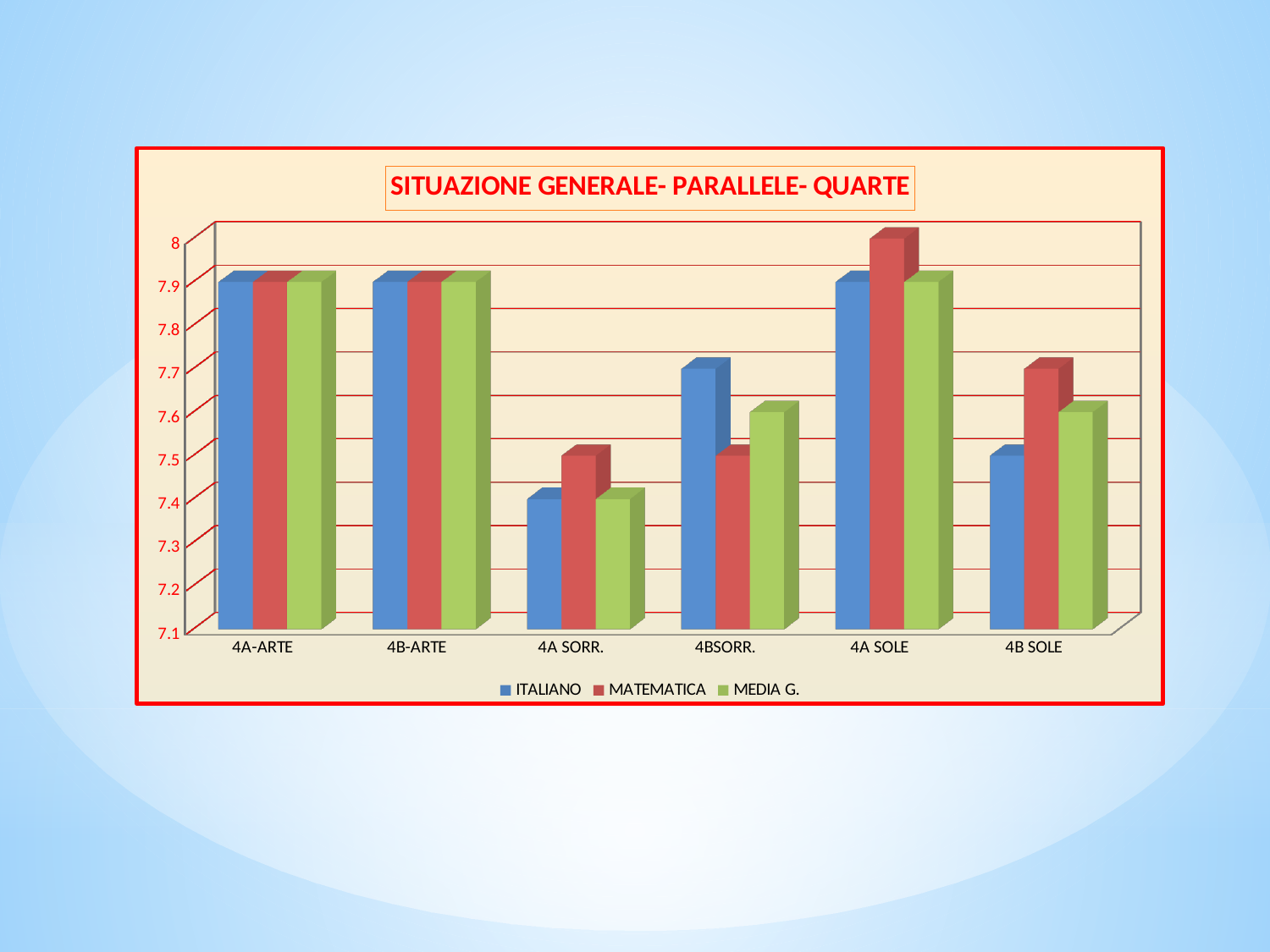
Which category has the lowest ITALIANO value? 4A SORR. Which series is shown in green in the legend? MEDIA G. What is the title of the chart? SITUAZIONE GENERALE- PARALLELE- QUARTE Which is larger for 4BSORR., the ITALIANO value or the MATEMATICA value? ITALIANO Is the MATEMATICA value for 4A SOLE greater or less than 7.9? greater What kind of chart is shown on the slide? bar chart Is the ITALIANO value for 4A SORR. greater or less than 7.5? less Is the ITALIANO value for 4BSORR. greater or less than 7.6? greater How many categories are shown on the x axis? 6 Which is larger for 4B SOLE, the ITALIANO value or the MATEMATICA value? MATEMATICA How many series does the legend list? 3 Which category has the highest MATEMATICA value? 4A SOLE